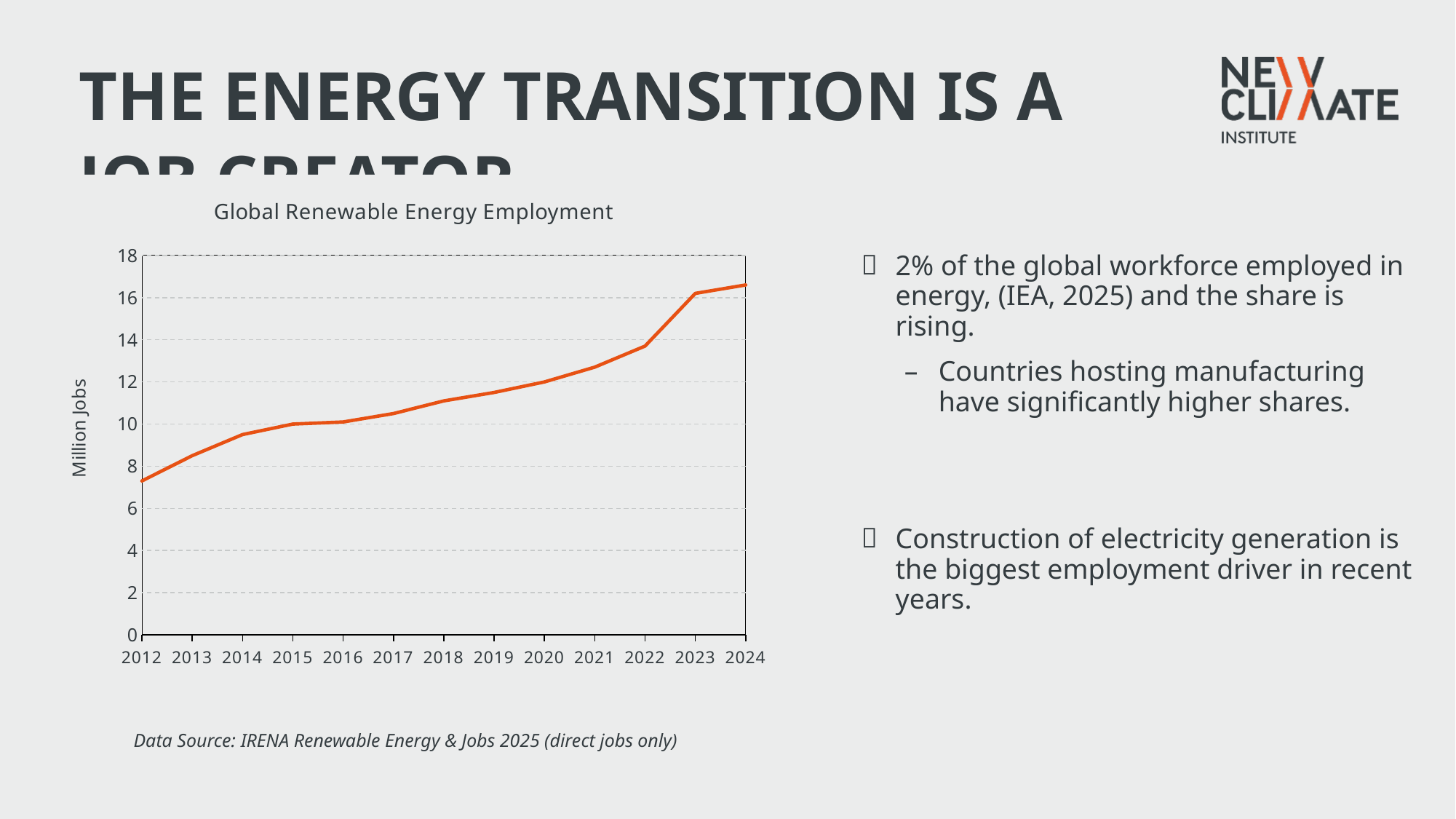
Is the value for 2024 greater or less than 16? greater Is the value for 2014 greater or less than 10? less What is the title of the chart? Global Renewable Energy Employment Which year has the lowest value in the chart? 2012 Is the value for 2012 greater or less than 8? less How many years are plotted on the x axis of the chart? 13 Which year has the highest value in the chart? 2024 Do the values rise or fall from 2012 to 2024? rise What is the label on the y axis of the chart? Million Jobs What kind of chart is shown on the slide? line chart